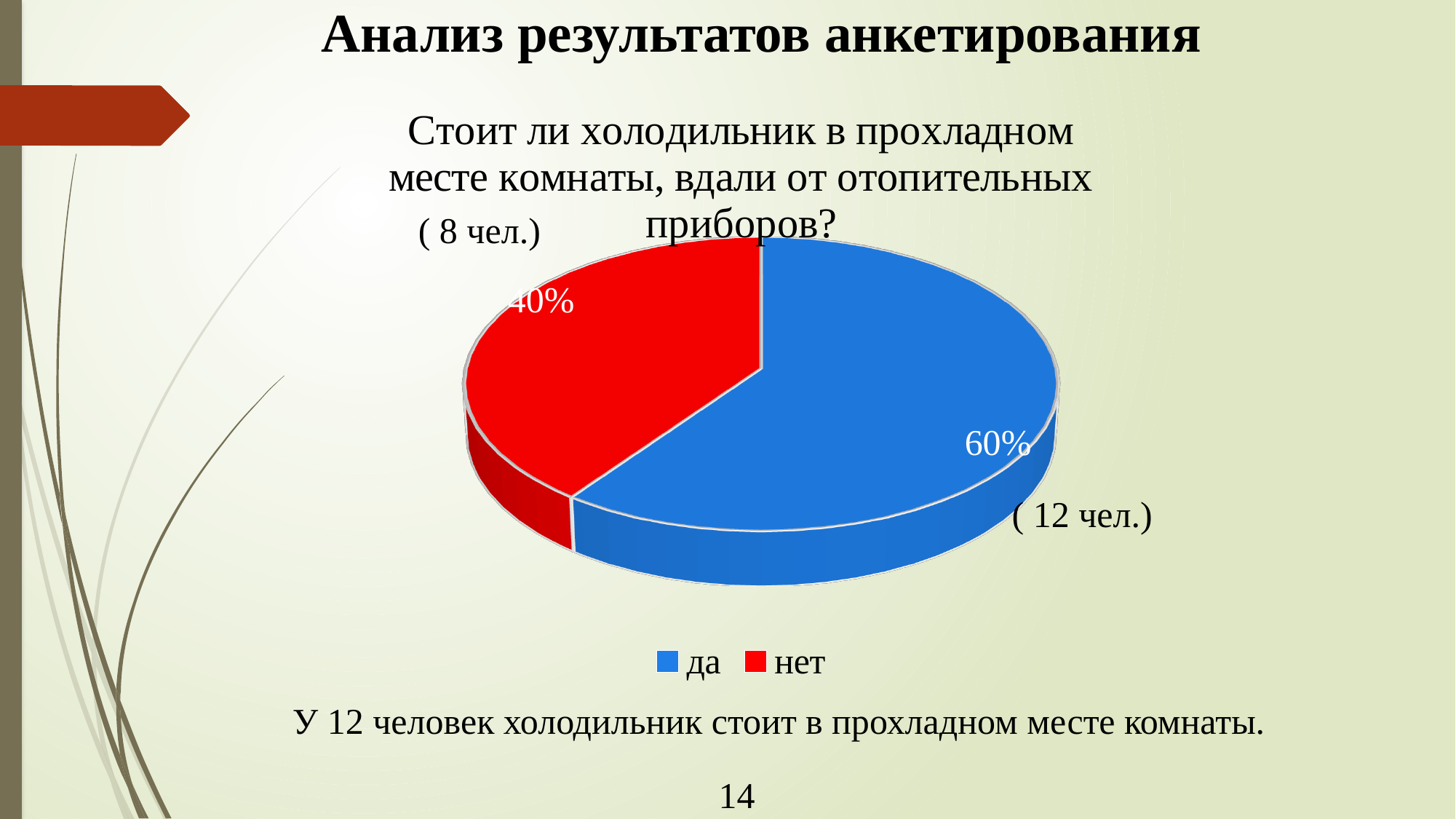
What colour is the "нет" slice? red How many slices does the pie chart have? 2 Which slice is larger, "да" or "нет"? да What kind of chart is shown on the slide? pie chart Which slice is the largest in the pie chart? да What percentage of the pie is the "нет" slice? 40% How many people are indicated next to the "да" slice? 12 чел. What percentage of the pie is the "да" slice? 60% How many people are indicated next to the "нет" slice? 8 чел. How many entries does the legend list? 2 What is the difference in percentage points between the "да" and "нет" slices? 20% Which slice is the smallest in the pie chart? нет